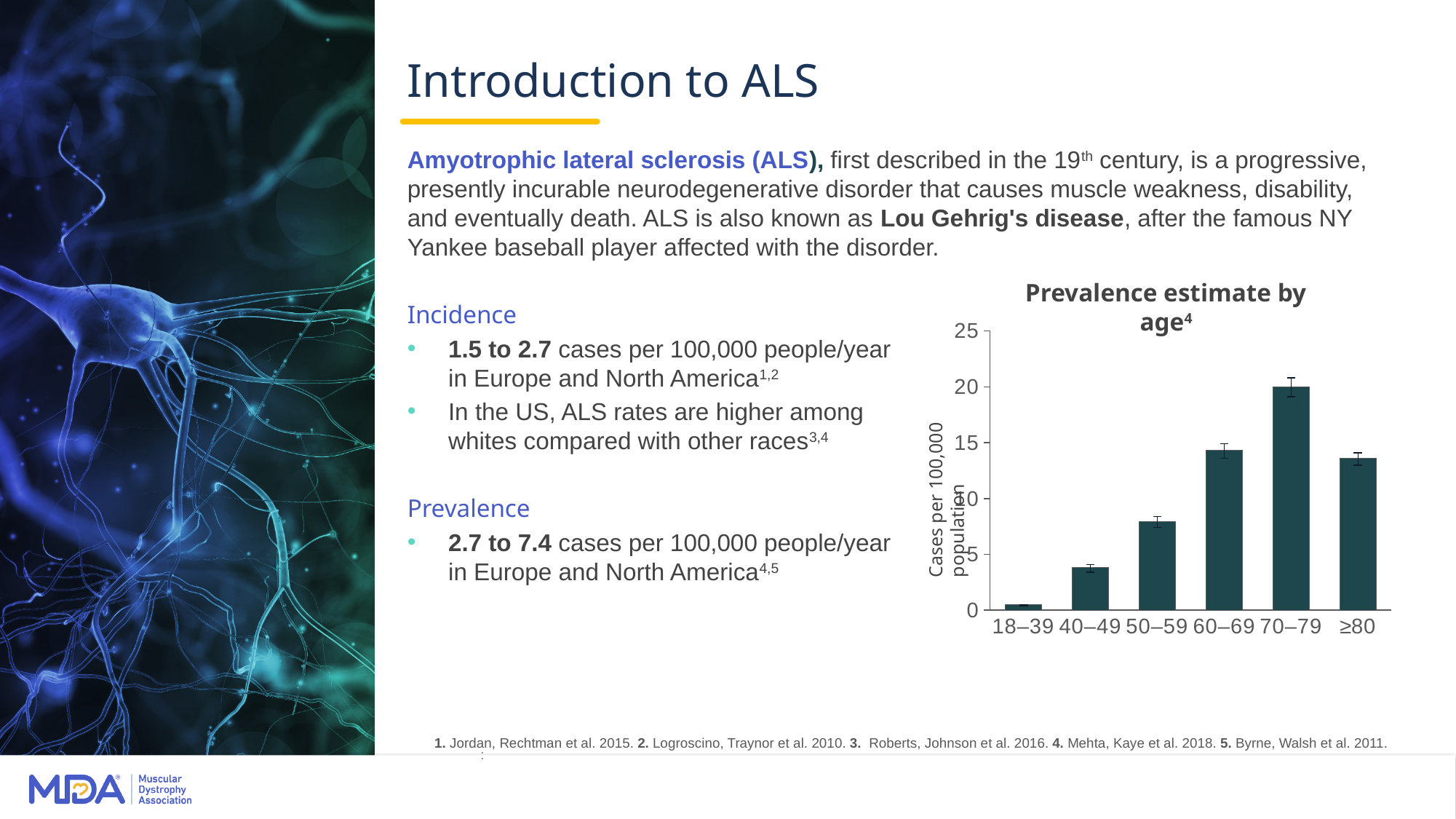
What is the label of the y axis of the chart? Cases per 100,000 population How many age categories are shown on the x axis of the chart? 6 Which has a higher prevalence estimate, the 50–59 age group or the 40–49 age group? 50–59 Do the prevalence estimates rise or fall from the 18–39 age group to the 70–79 age group? rise Which age group has the lowest prevalence estimate? 18–39 Is the prevalence estimate for the 60–69 age group greater or less than 10? greater What is the title of the chart? Prevalence estimate by age Is the prevalence estimate for the 50–59 age group greater or less than 5? greater Is the prevalence estimate for the 40–49 age group greater or less than 5? less Which age group has the highest prevalence estimate? 70–79 What kind of chart is shown on the slide? bar chart